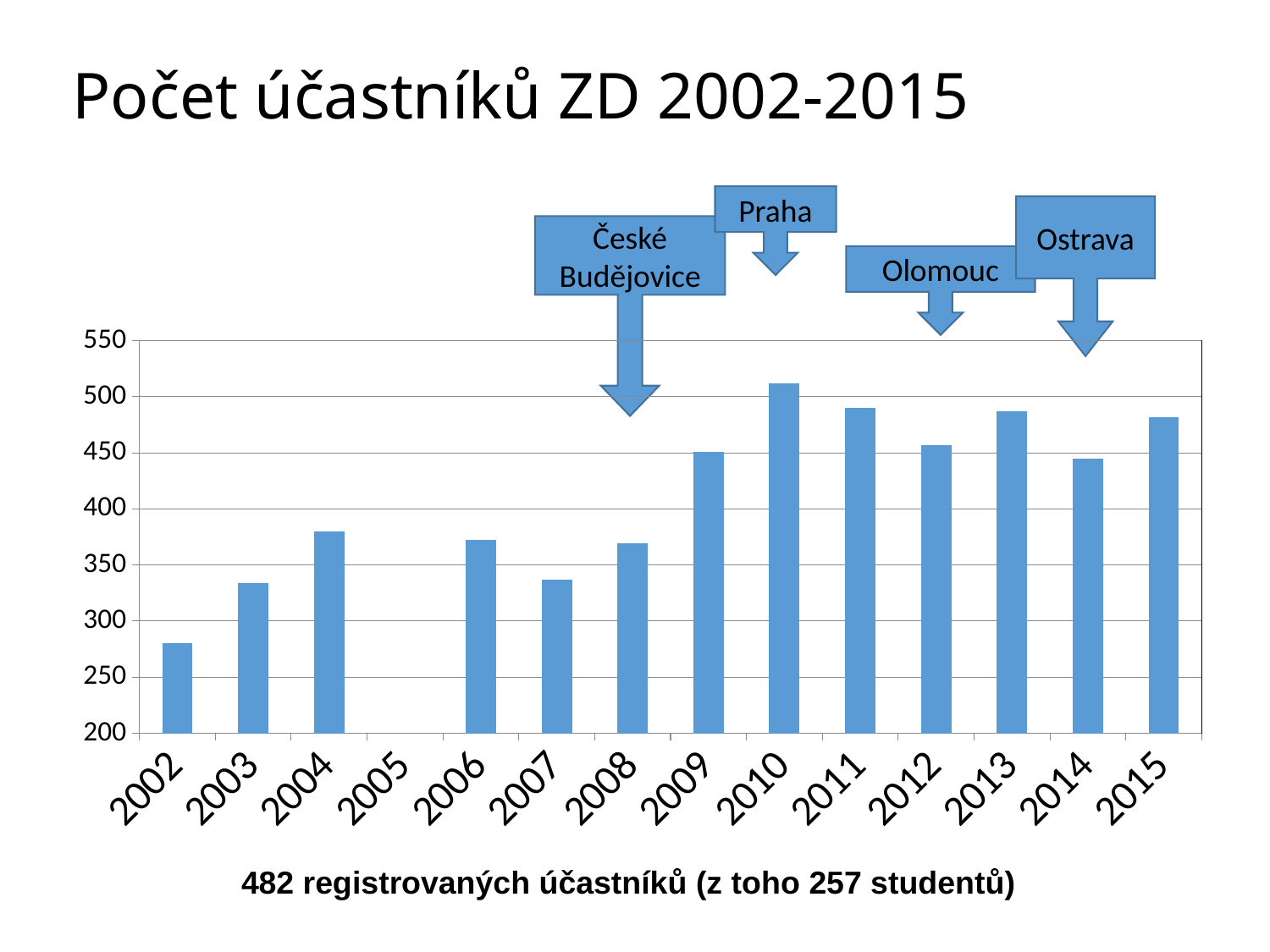
Which is larger, the value for 2004 or the value for 2003? 2004 Which year has the highest bar in the chart? 2010 Which is larger, the value for 2011 or the value for 2012? 2011 Is the value for 2009 greater or less than 400? greater Is the value for 2010 greater or less than 500? greater Do the values rise or fall from 2002 to 2004? rise What kind of chart is shown on the slide? bar chart Among the years with a bar shown, which year has the lowest value? 2002 Is the value for 2002 greater or less than 300? less Which city is named in the callout pointing at the 2008 bar? České Budějovice How many years are labelled on the x axis of the chart? 14